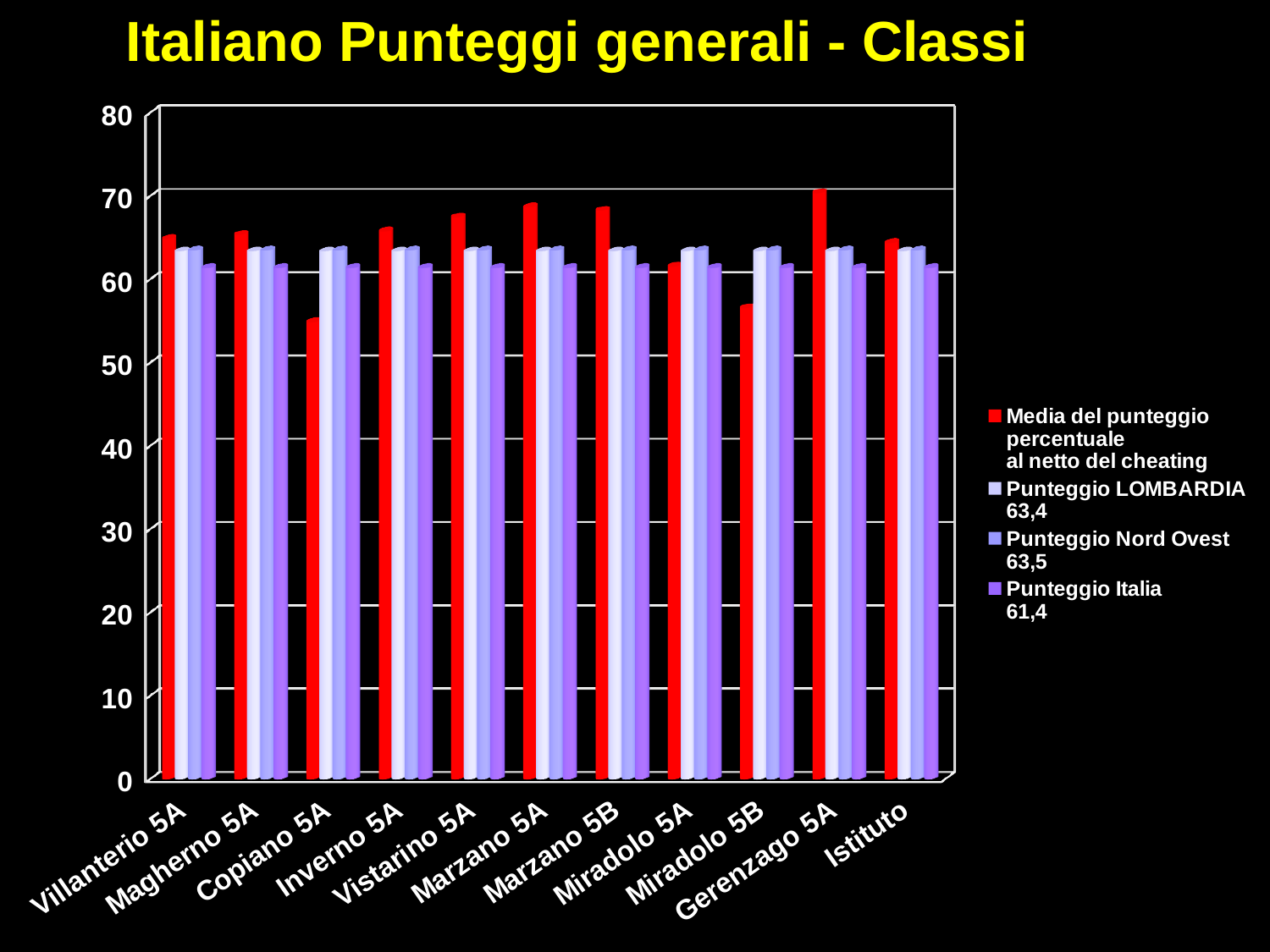
How many series does the legend list? 4 Which class has the lowest 'Media del punteggio percentuale al netto del cheating' (red bar)? Copiano 5A Which has a larger red bar value, Marzano 5A or Miradolo 5B? Marzano 5A What type of chart is shown on the slide? bar chart What is the Punteggio Nord Ovest value given in the legend? 63,5 Is the red bar value for Villanterio 5A greater or less than 60? greater What is the title of the chart? Italiano Punteggi generali - Classi How many categories are shown on the x axis? 11 What is the Punteggio Italia value given in the legend? 61,4 Is the red bar value for Copiano 5A greater or less than 60? less Which class has the highest 'Media del punteggio percentuale al netto del cheating' (red bar)? Gerenzago 5A What is the Punteggio LOMBARDIA value given in the legend? 63,4